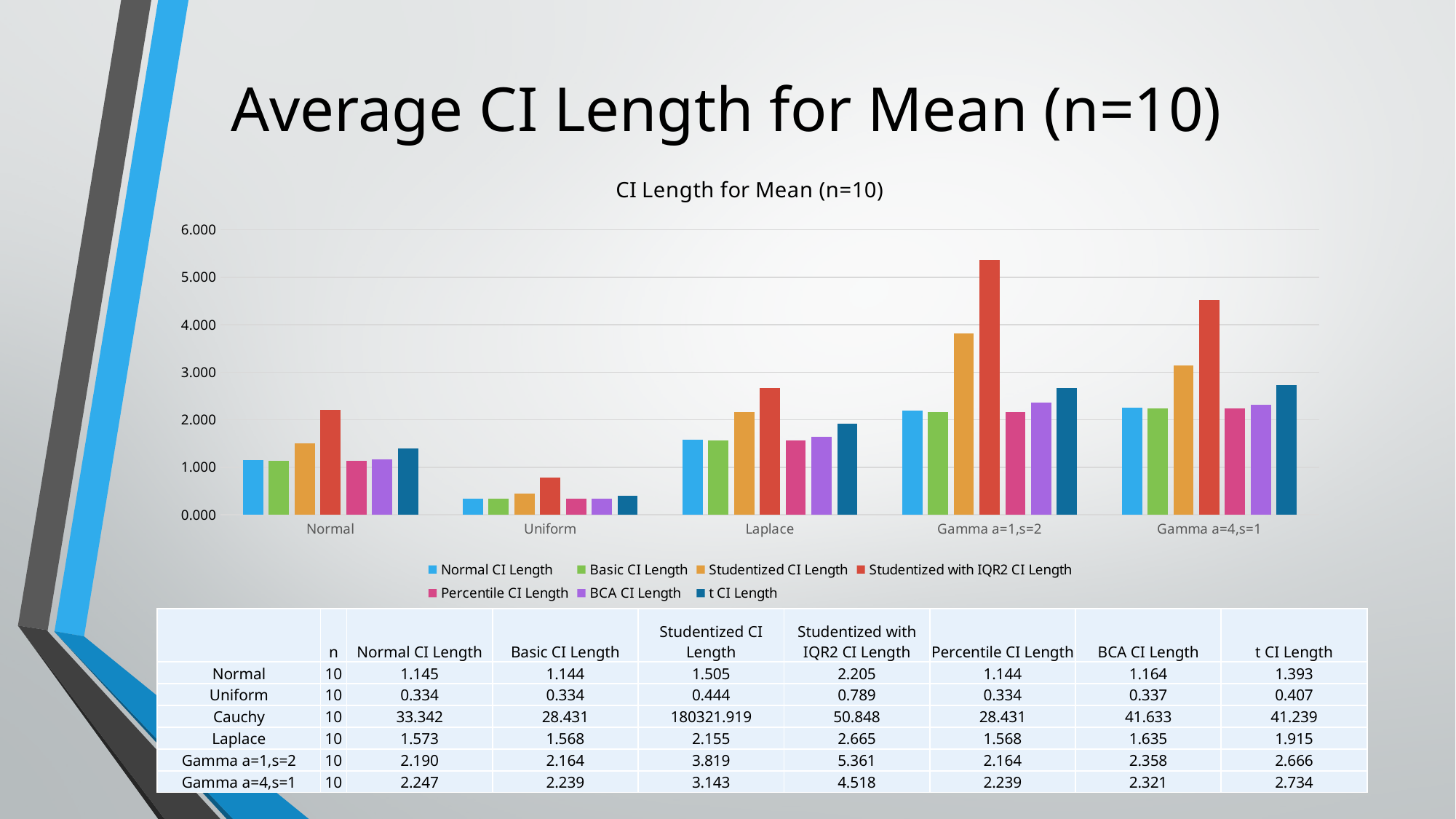
What is the t CI Length for the Laplace distribution? 1.915 How many distribution categories are plotted along the x axis of the chart? 5 Which series is shown in red in the chart? Studentized with IQR2 CI Length Which is larger for the Laplace distribution: the BCA CI Length or the t CI Length? t CI Length What is the title of the chart? CI Length for Mean (n=10) What kind of chart is shown on the slide? bar chart What is the difference between the Studentized CI Length and the Normal CI Length for the Gamma a=4,s=1 distribution? 0.896 What is the Studentized with IQR2 CI Length for the Gamma a=1,s=2 distribution? 5.361 How many series does the chart legend list? 7 Which distribution has the highest Studentized with IQR2 CI Length among those plotted in the chart? Gamma a=1,s=2 Which distribution has the lowest Normal CI Length in the chart? Uniform Is the Studentized with IQR2 CI Length for Gamma a=4,s=1 greater or less than 4.000? greater